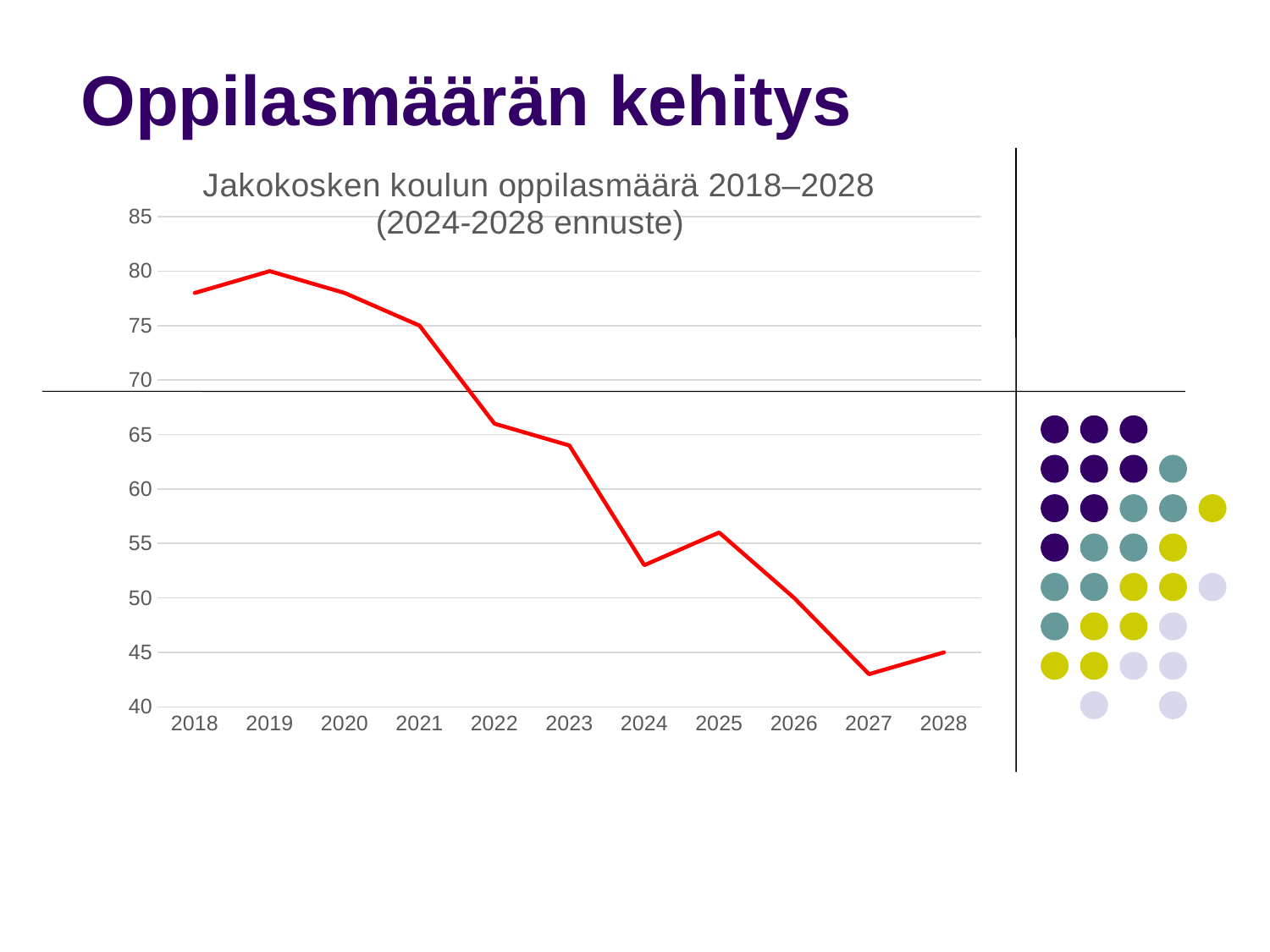
Which year has the lowest number of pupils? 2027 What is the title of the chart? Jakokosken koulun oppilasmäärä 2018–2028 (2024-2028 ennuste) What is the number of pupils in 2021? 75 How many years are plotted on the x axis? 11 What is the number of pupils in 2028? 45 What is the number of pupils in 2019? 80 What kind of chart is shown on the slide? line chart Which year has the highest number of pupils? 2019 Is the value for 2024 greater or less than 50? greater Do the values generally rise or fall from 2018 to 2028? fall Is the value for 2022 greater or less than 70? less Which is larger, the value for 2018 or the value for 2027? 2018